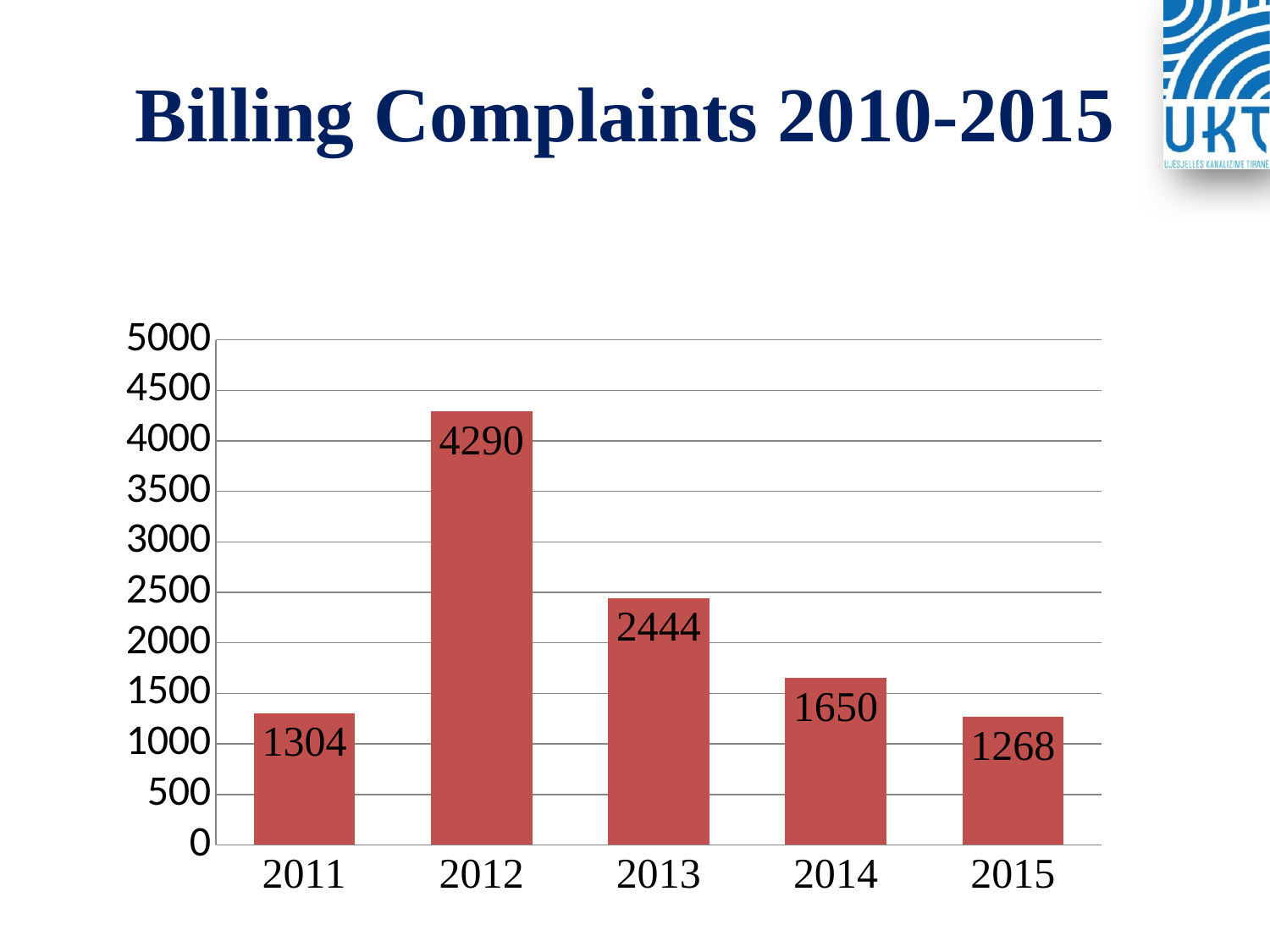
What is the difference between the values for 2012 and 2013? 1846 What kind of chart is shown on the slide? bar chart Is the value for 2013 greater or less than 2000? greater Which year has the lowest value? 2015 What is the value for 2015? 1268 Which is larger, the value for 2013 or the value for 2014? 2013 How many years are shown on the x axis? 5 Do the values rise or fall from 2012 to 2015? fall Which year has the highest value? 2012 What is the value for 2012? 4290 What is the value for 2014? 1650 What is the difference between the values for 2011 and 2015? 36